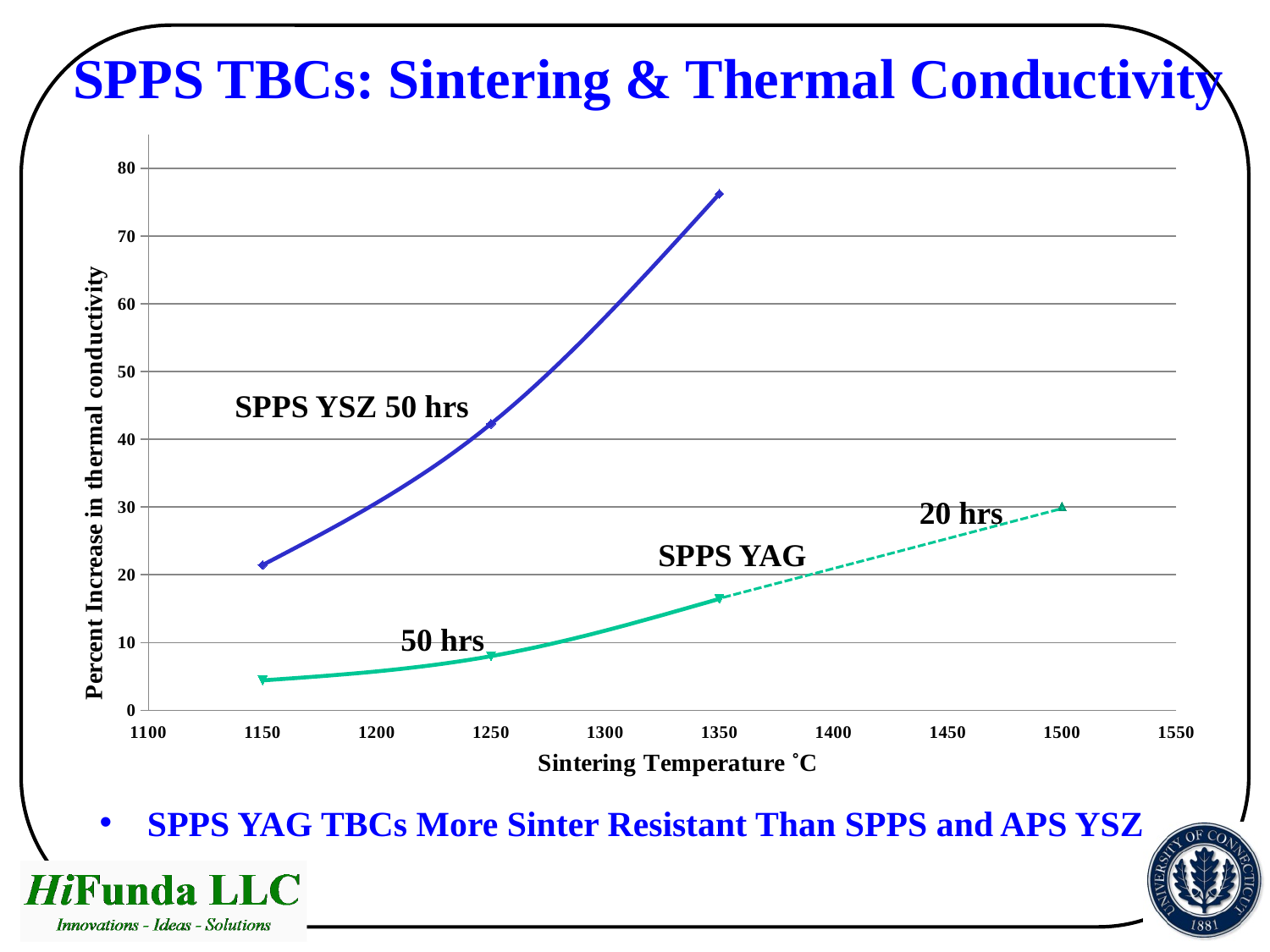
Is the value for SPPS YSZ 50 hrs at 1250 °C greater or less than 40? greater Does the SPPS YSZ 50 hrs line rise or fall as sintering temperature increases? rise What is the label of the x axis? Sintering Temperature ˚C Is the value for SPPS YAG 50 hrs at 1350 °C greater or less than 20? less At 1350 °C, which series has the higher percent increase in thermal conductivity, SPPS YSZ 50 hrs or SPPS YAG? SPPS YSZ 50 hrs How many data points are plotted for the SPPS YSZ 50 hrs series? 3 Is the value for SPPS YSZ 50 hrs at 1150 °C greater or less than 30? less What kind of chart is shown on the slide? line chart At which sintering temperature does the SPPS YSZ 50 hrs series reach its highest value? 1350 What is the title of the chart on the slide? SPPS TBCs: Sintering & Thermal Conductivity